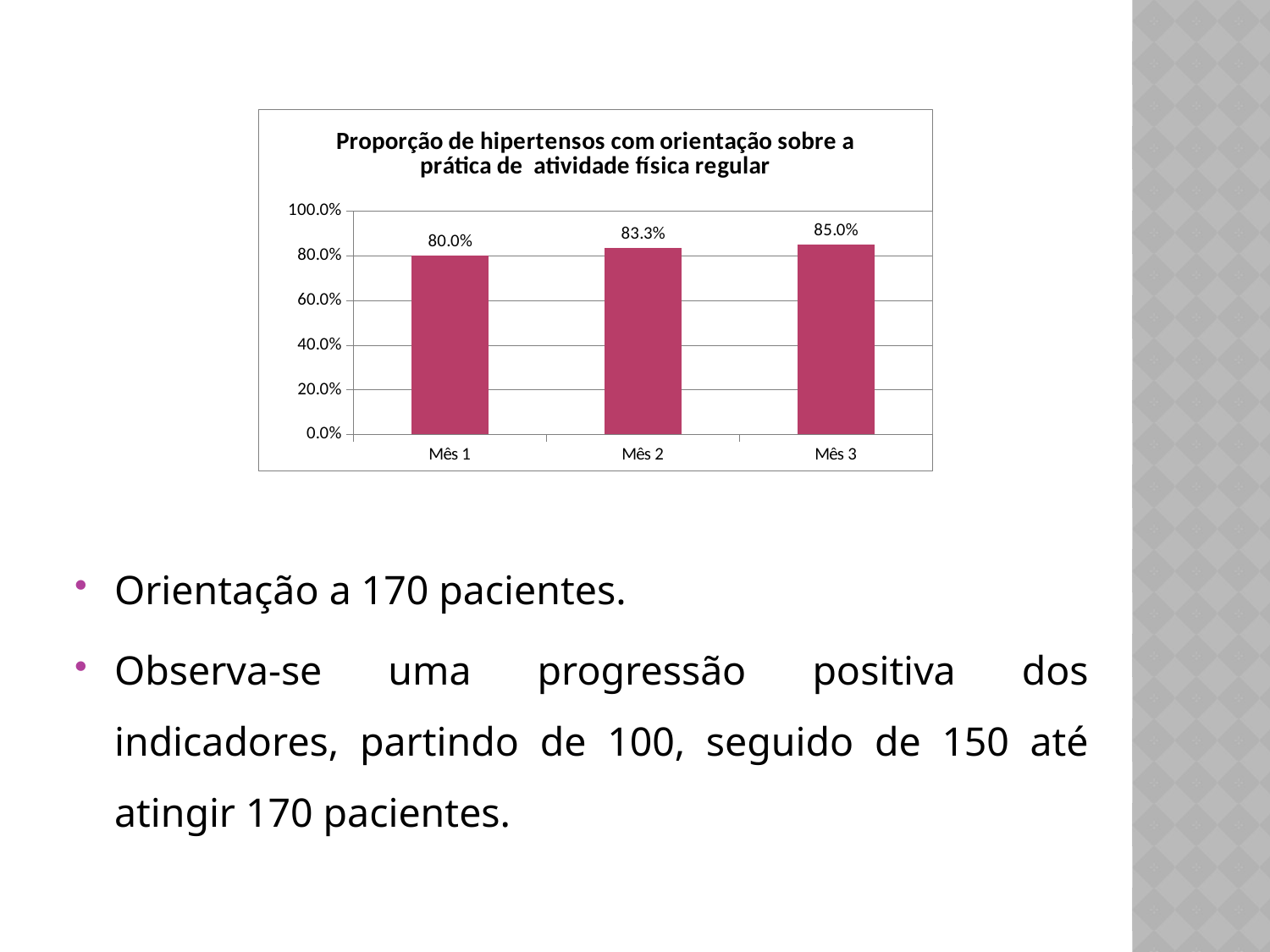
How many months are shown on the x axis? 3 What is the value for Mês 2? 83.3% Which is larger, the value for Mês 2 or the value for Mês 1? Mês 2 Which month has the highest value? Mês 3 Do the values rise or fall from Mês 1 to Mês 3? rise What is the difference between the values for Mês 3 and Mês 1? 5.0% Is the value for Mês 2 greater or less than 60.0%? greater What is the value for Mês 3? 85.0% What is the value for Mês 1? 80.0% What is the title of the chart? Proporção de hipertensos com orientação sobre a prática de atividade física regular Which month has the lowest value? Mês 1 What kind of chart is shown on the slide? bar chart